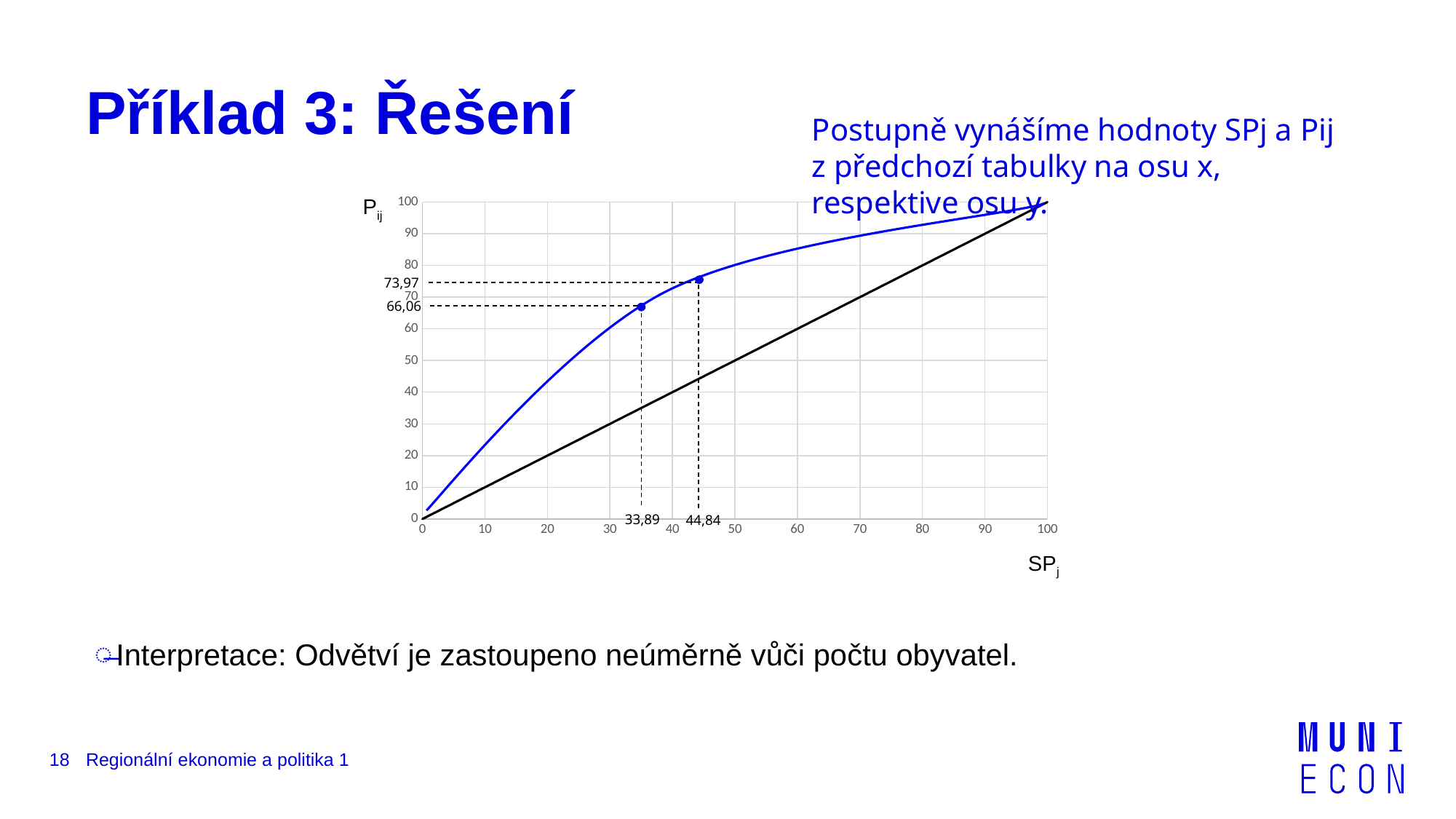
What is the difference in P_ij between the two marked points (73,97 and 66,06)? 7,91 What is the P_ij value of the marked point at SP_j = 44,84? 73,97 What is the difference in SP_j between the two marked points (44,84 and 33,89)? 10,95 How many points are marked with dashed guide lines on the blue curve? 2 Is the P_ij value of the blue curve at SP_j = 20 greater or less than 40? greater Is the P_ij value of the blue curve at SP_j = 50 greater or less than 70? greater What is the label of the vertical axis? P_ij What is the P_ij value of the marked point at SP_j = 33,89? 66,06 Which of the two marked points has the higher P_ij value, the one at SP_j = 33,89 or the one at SP_j = 44,84? the one at SP_j = 44,84 What kind of chart is shown on the slide? line chart What is the SP_j value of the marked point whose P_ij is 73,97? 44,84 Does the blue curve rise or fall as SP_j increases from 0 to 100? rises